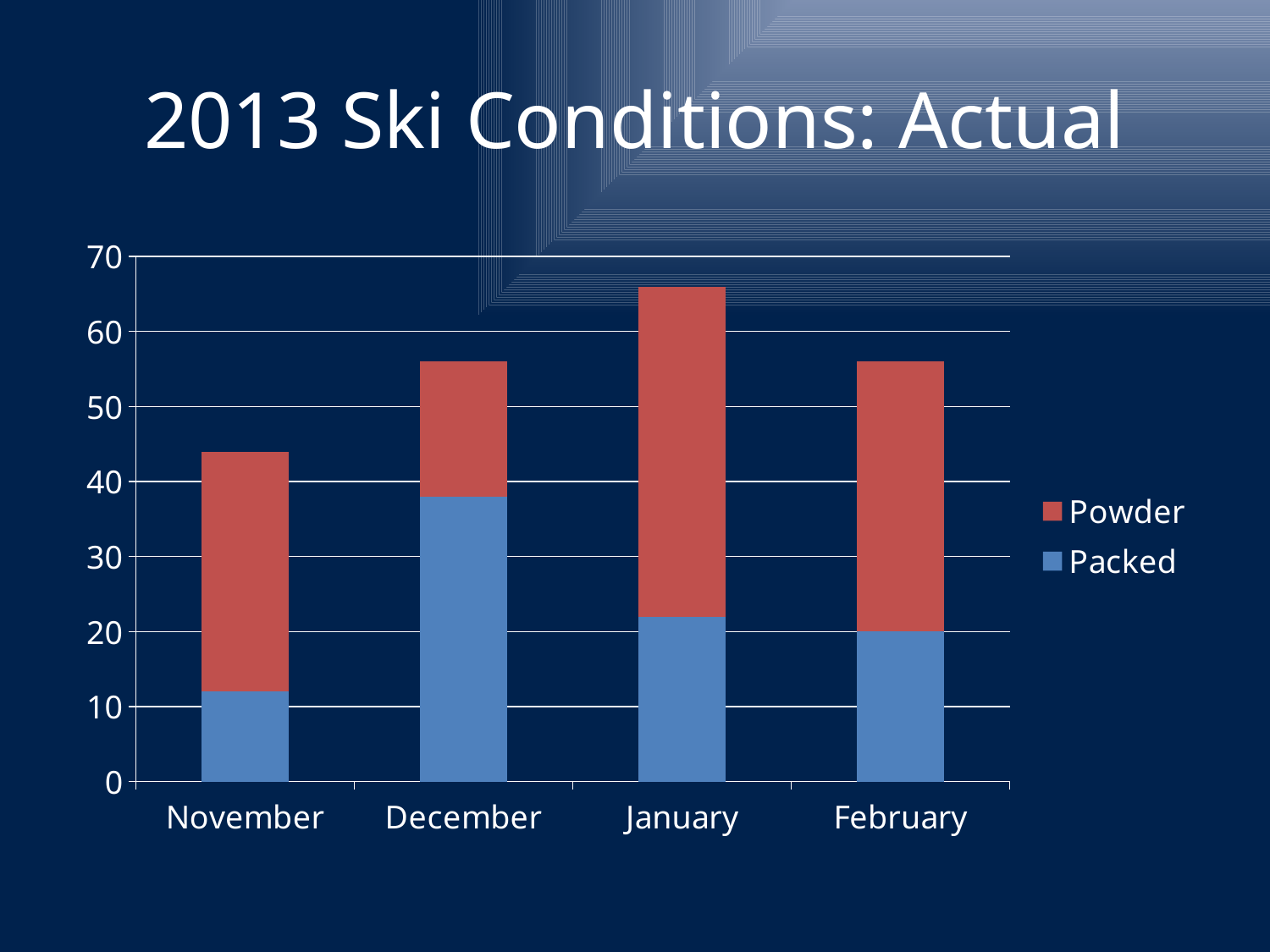
Which month has the largest Packed value? December Which month has the highest total stacked bar? January Which month has the lowest total stacked bar? November How many series does the legend list? 2 Is the total for November greater or less than 50? less How many months are shown on the x axis? 4 Is the Packed value for December greater or less than 30? greater What kind of chart is shown on the slide? Stacked bar chart Which is larger, the total bar for November or the total bar for December? December What is the Packed value for February? 20 What is the title of the chart? 2013 Ski Conditions: Actual Which colour represents Powder in the chart? Red